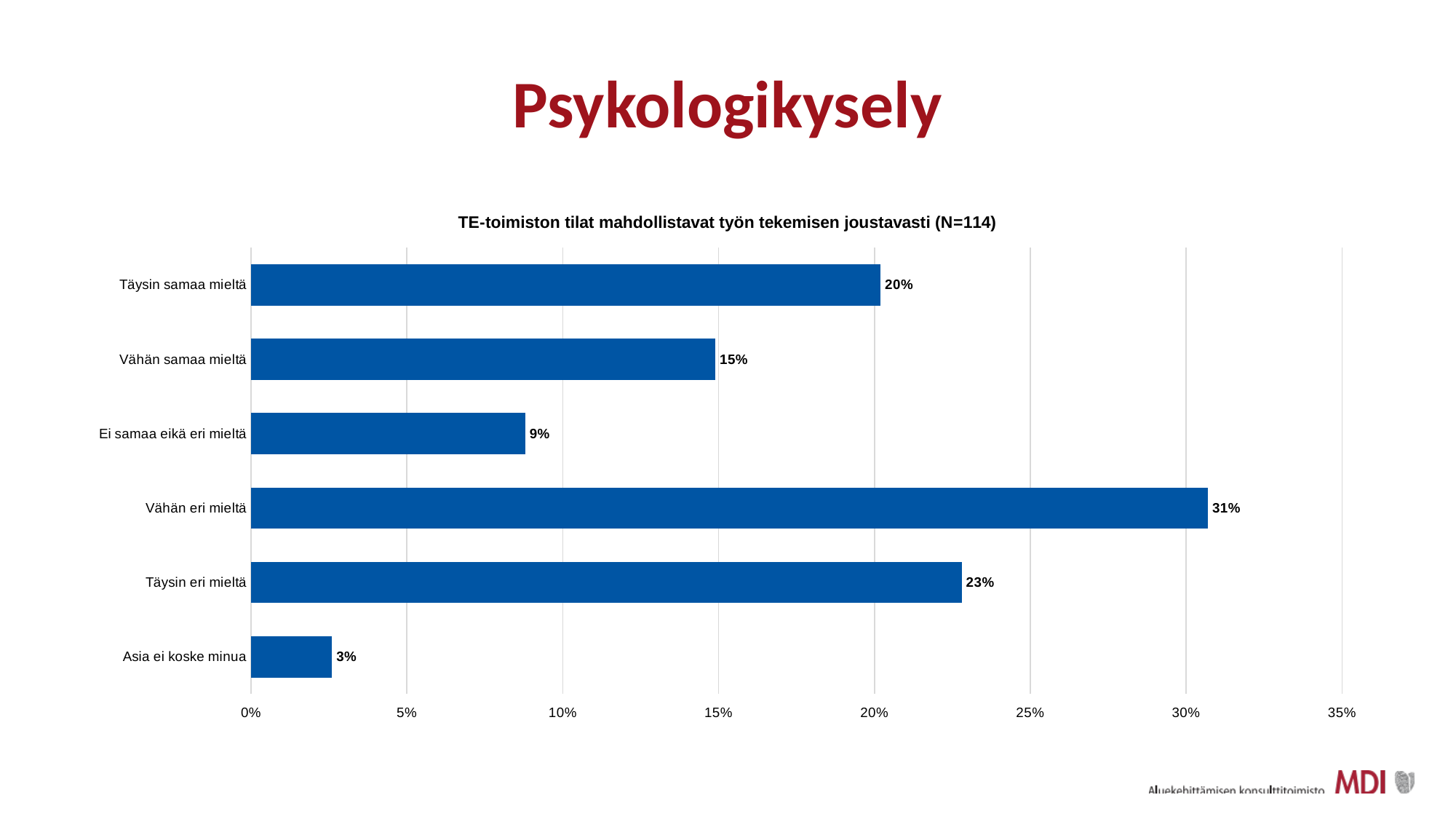
What is the value for "Vähän eri mieltä"? 31% What is the value for "Asia ei koske minua"? 3% Which category has the highest value? Vähän eri mieltä What is the value for "Täysin samaa mieltä"? 20% Which is larger, the value for "Täysin samaa mieltä" or the value for "Vähän samaa mieltä"? Täysin samaa mieltä Is the value for "Täysin eri mieltä" greater or less than 20%? greater What is the sample size (N) stated in the chart title? 114 Which category has the lowest value? Asia ei koske minua What is the value for "Ei samaa eikä eri mieltä"? 9% What kind of chart is shown on the slide? Bar chart What is the difference between the values for "Vähän eri mieltä" and "Täysin eri mieltä"? 8% How many categories are shown in the chart? 6